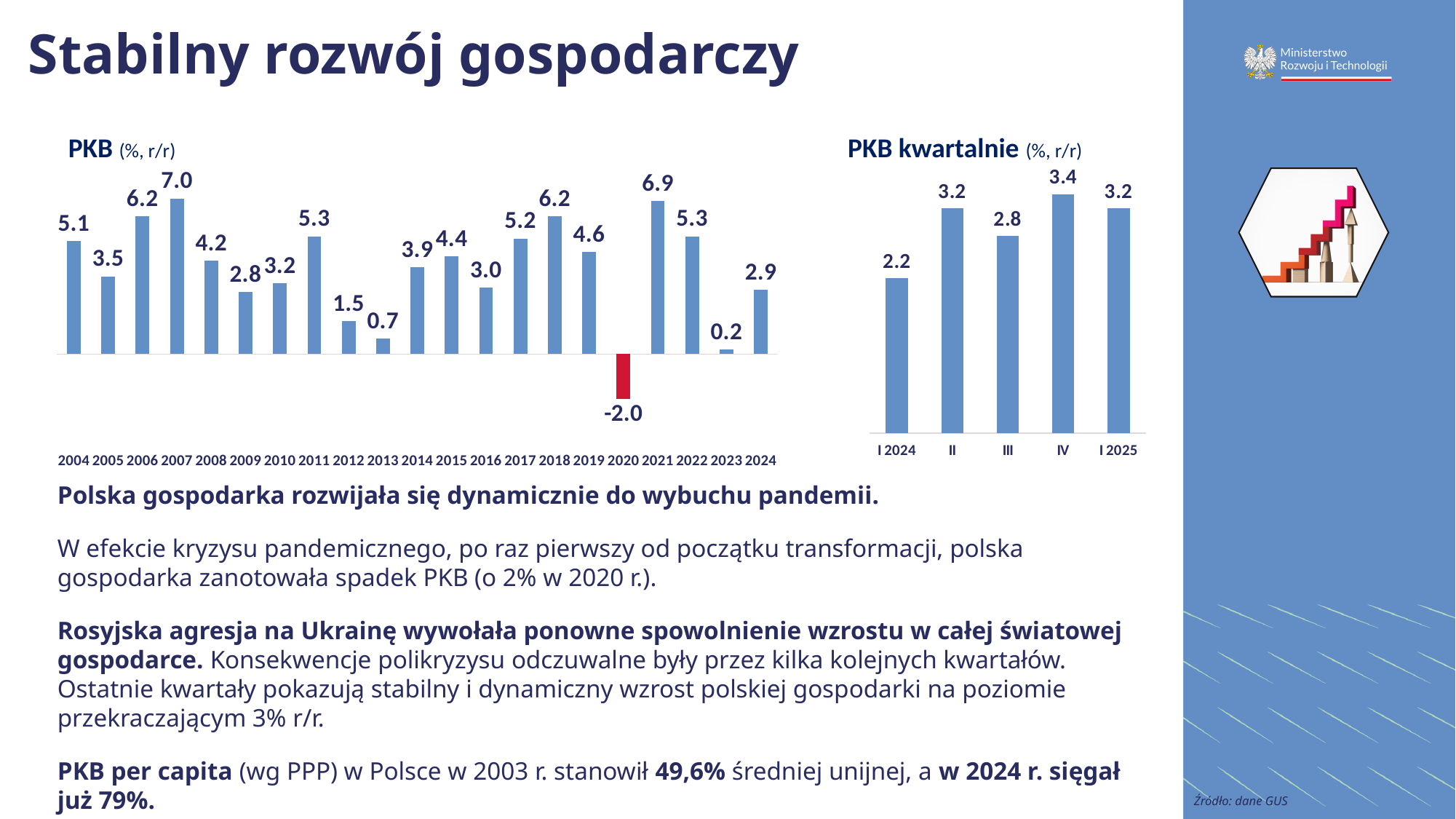
In the 'PKB (%, r/r)' chart, what is the value for 2020? -2.0 In the 'PKB (%, r/r)' chart, which bar is coloured red instead of blue? 2020 How many years are shown in the 'PKB (%, r/r)' chart? 21 In the 'PKB kwartalnie (%, r/r)' chart, which quarter has the highest value? IV In the 'PKB kwartalnie (%, r/r)' chart, what is the value for I 2025? 3.2 In the 'PKB (%, r/r)' chart, what is the difference between the values for 2021 and 2022? 1.6 In the 'PKB kwartalnie (%, r/r)' chart, what is the difference between the values for IV and I 2024? 1.2 In the 'PKB (%, r/r)' chart, which is larger, the value for 2012 or the value for 2013? 2012 In the 'PKB (%, r/r)' chart, which year has the lowest value? 2020 In the 'PKB (%, r/r)' chart, what is the value for 2007? 7.0 In the 'PKB (%, r/r)' chart, which year has the highest value? 2007 What kind of chart is the 'PKB kwartalnie (%, r/r)' chart? bar chart